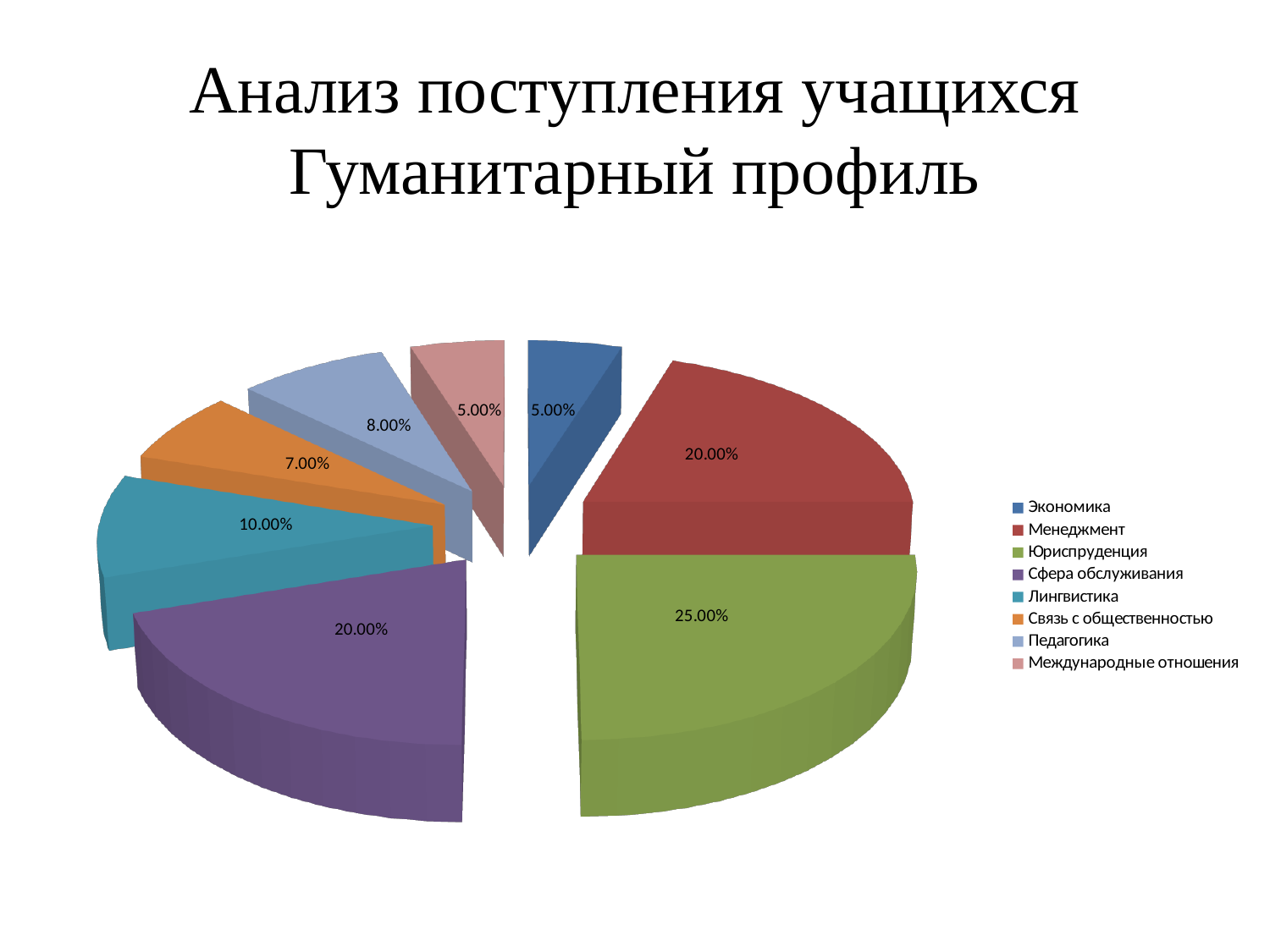
What kind of chart is shown on the slide? pie chart What is the value shown for Связь с общественностью? 7.00% What share of the pie does Юриспруденция have? 25.00% What is the value shown for Педагогика? 8.00% Which category has the largest slice of the pie? Юриспруденция What is the difference between the values for Менеджмент and Экономика? 15.00% What is the difference between the values for Юриспруденция and Сфера обслуживания? 5.00% What is the value shown for Лингвистика? 10.00% What is the title of the slide containing the chart? Анализ поступления учащихся Гуманитарный профиль How many categories does the pie chart have? 8 Which is larger, the value for Лингвистика or the value for Педагогика? Лингвистика What is the value shown for Менеджмент? 20.00%